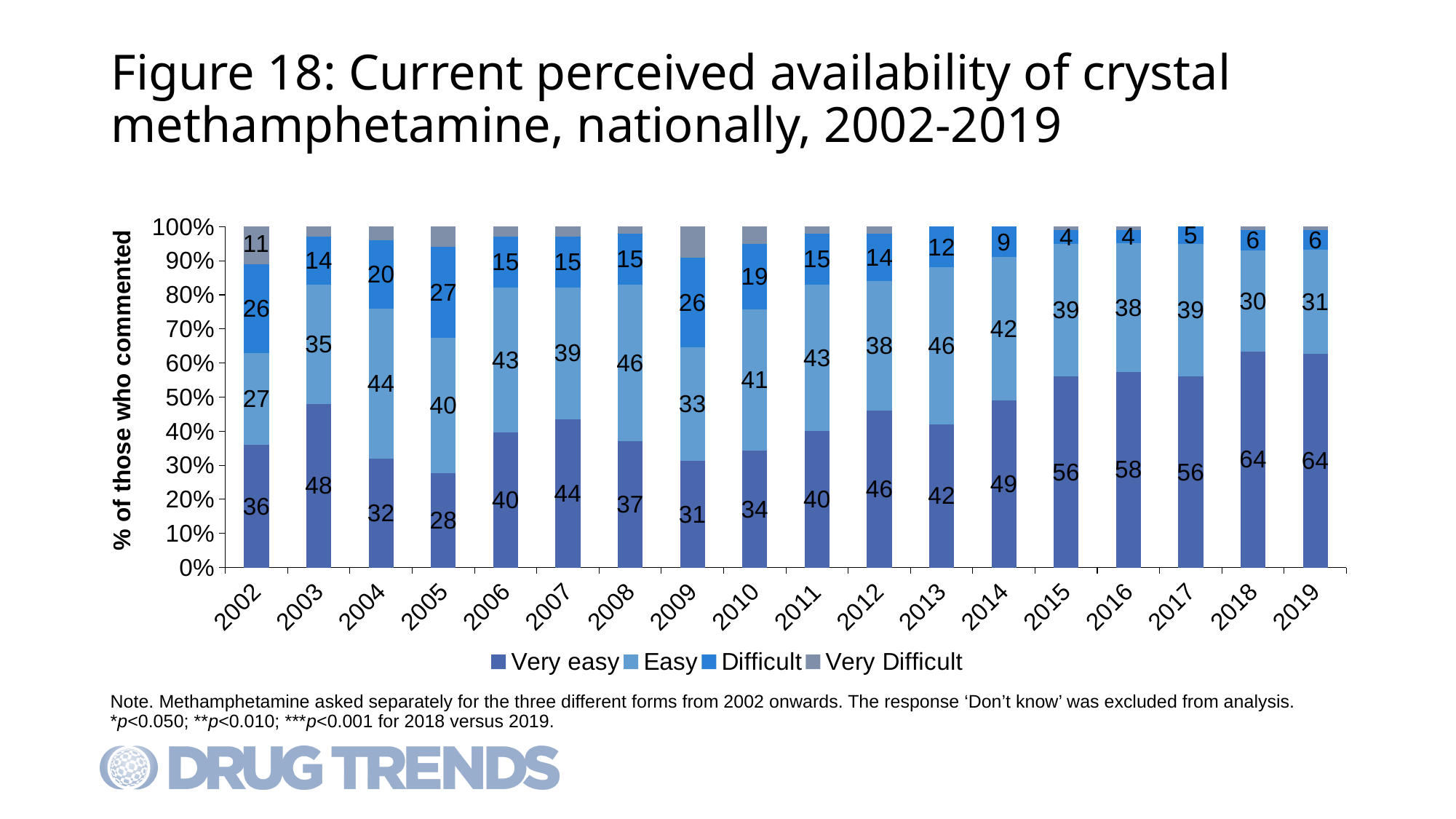
What percentage of respondents rated crystal methamphetamine as 'Very easy' to obtain in 2019? 64 In which year is the 'Easy' value lowest? 2002 How many series does the legend list? 4 How many years are shown on the x axis? 18 What is the difference between the 'Very easy' value in 2019 and in 2002? 28 What is the 'Difficult' value for 2005? 27 Does the 'Difficult' value rise or fall from 2009 to 2016? fall What is the 'Very Difficult' value for 2002? 11 In which year is the 'Difficult' value highest? 2005 Is the 'Very Difficult' value for 2004 greater or less than 10%? less In which year is the 'Very easy' value lowest? 2005 Which year has the larger 'Very easy' value, 2003 or 2004? 2003